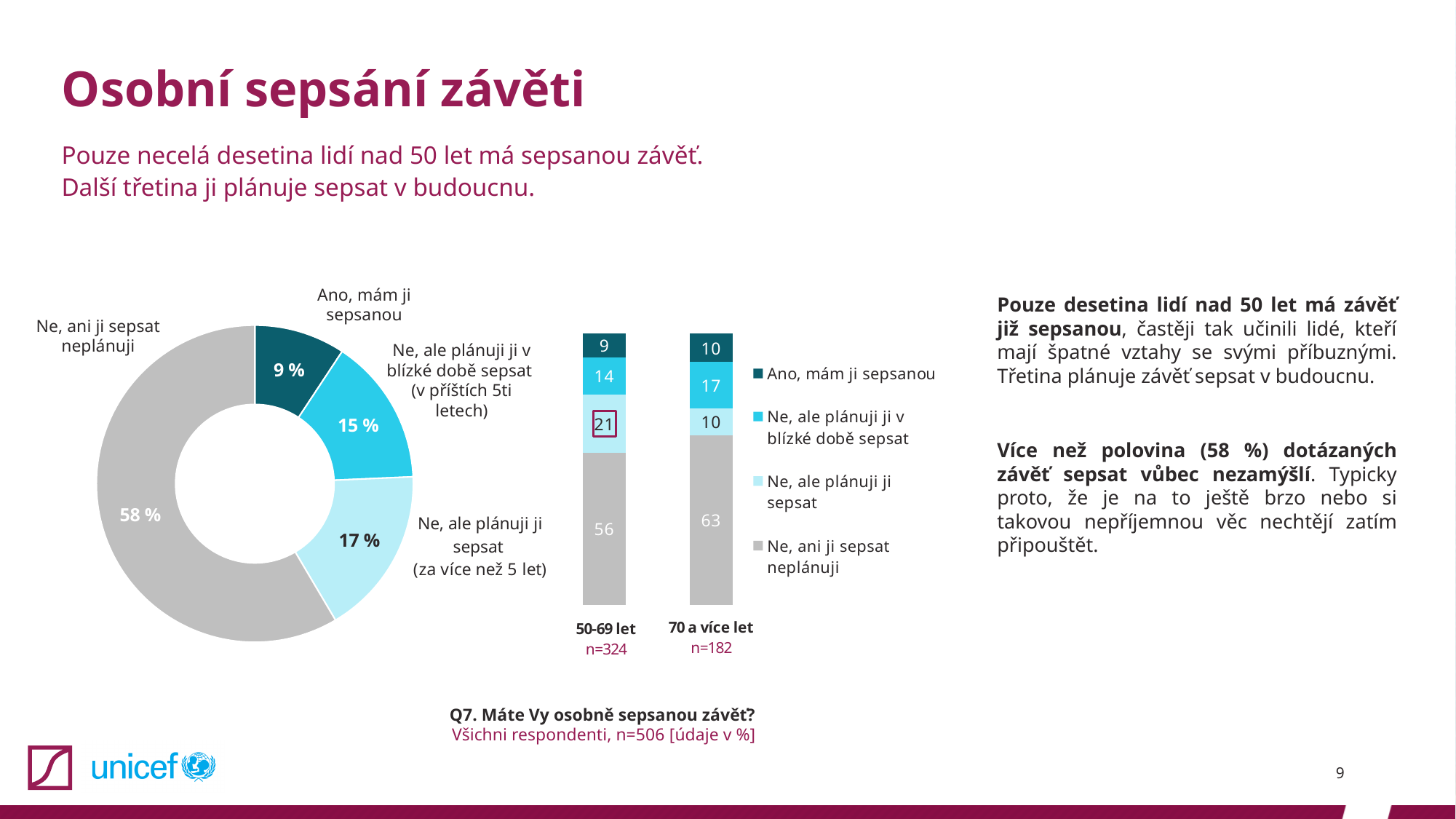
In the donut chart on the left, what share of respondents answered "Ne, ani ji sepsat neplánuji"? 58 % In the stacked bar chart on the right, what is the difference between the "Ne, ani ji sepsat neplánuji" values of the 70 a více let and 50-69 let groups? 7 What type of chart is the chart on the left of the slide? Donut chart In the donut chart on the left, which category has the largest share? Ne, ani ji sepsat neplánuji In the stacked bar chart on the right, which age group has the higher value for "Ne, ale plánuji ji v blízké době sepsat"? 70 a více let How many age groups are shown in the stacked bar chart on the right? 2 In the donut chart on the left, what share of respondents answered "Ano, mám ji sepsanou"? 9 % In the donut chart on the left, what is the difference in percentage points between "Ne, ale plánuji ji sepsat (za více než 5 let)" and "Ne, ale plánuji ji v blízké době sepsat"? 2 In the donut chart on the left, which category has the smallest share? Ano, mám ji sepsanou In the stacked bar chart on the right, what is the value for "Ne, ale plánuji ji sepsat" in the 50-69 let group? 21 In the stacked bar chart on the right, what is the value for "Ne, ani ji sepsat neplánuji" in the 70 a více let group? 63 How many series does the legend of the stacked bar chart on the right list? 4